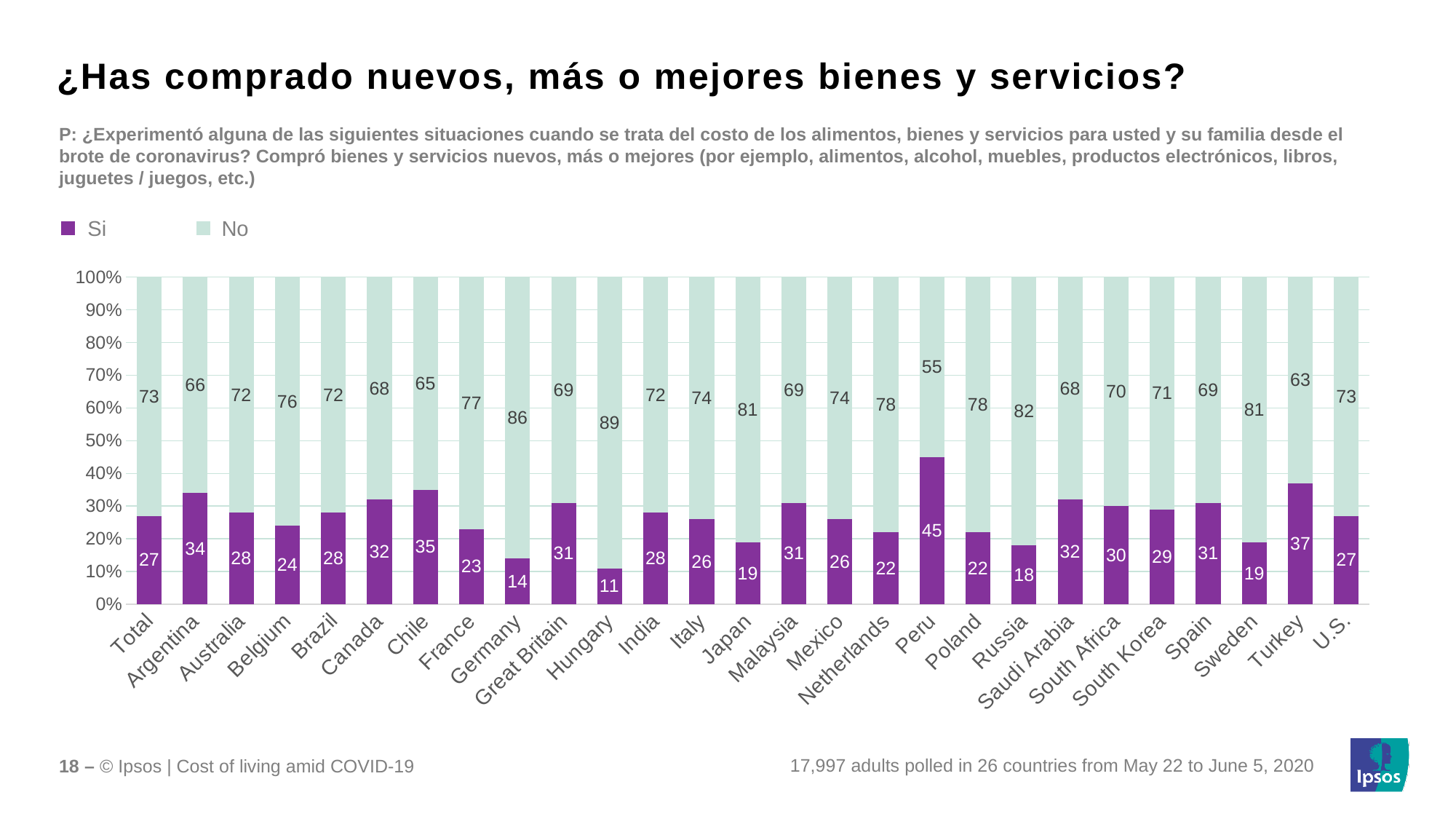
What is the 'No' value for Germany? 86 What is the 'Si' value for Total? 27 How many categories are shown on the x axis? 27 What is the 'Si' value for Peru? 45 What is the difference between the 'Si' values for Turkey and Sweden? 18 Which has a larger 'Si' value, Argentina or Chile? Chile How many series does the legend list? 2 What kind of chart is shown on the slide? Stacked bar chart Which country has the highest 'No' value? Hungary Which country has the highest 'Si' value? Peru Which country has the lowest 'Si' value? Hungary What is the total of the stacked bar for Japan? 100